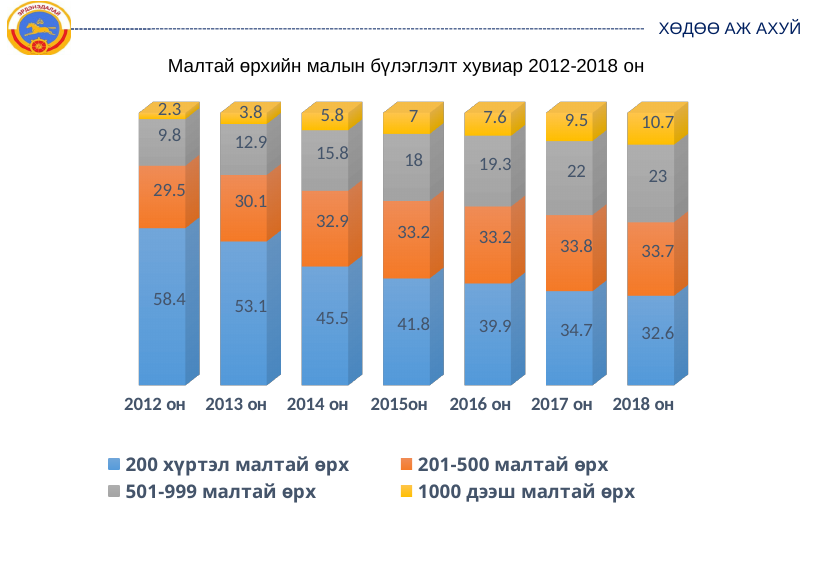
How many series does the legend list? 4 Which is larger in 2017 он: the value for '200 хүртэл малтай өрх' or for '201-500 малтай өрх'? 200 хүртэл малтай өрх How many years are shown on the x axis? 7 What is the total of the stacked bar for 2014 он? 100 Does the value for '200 хүртэл малтай өрх' rise or fall from 2012 он to 2018 он? Fall What is the value for '200 хүртэл малтай өрх' in 2012 он? 58.4 What is the difference between the '200 хүртэл малтай өрх' values in 2012 он and 2018 он? 25.8 What is the value for '1000 дээш малтай өрх' in 2018 он? 10.7 In which year is the value for '200 хүртэл малтай өрх' the lowest? 2018 он What is the value for '501-999 малтай өрх' in 2015он? 18 In which year is the value for '1000 дээш малтай өрх' the highest? 2018 он What type of chart is shown on the slide? Stacked bar chart